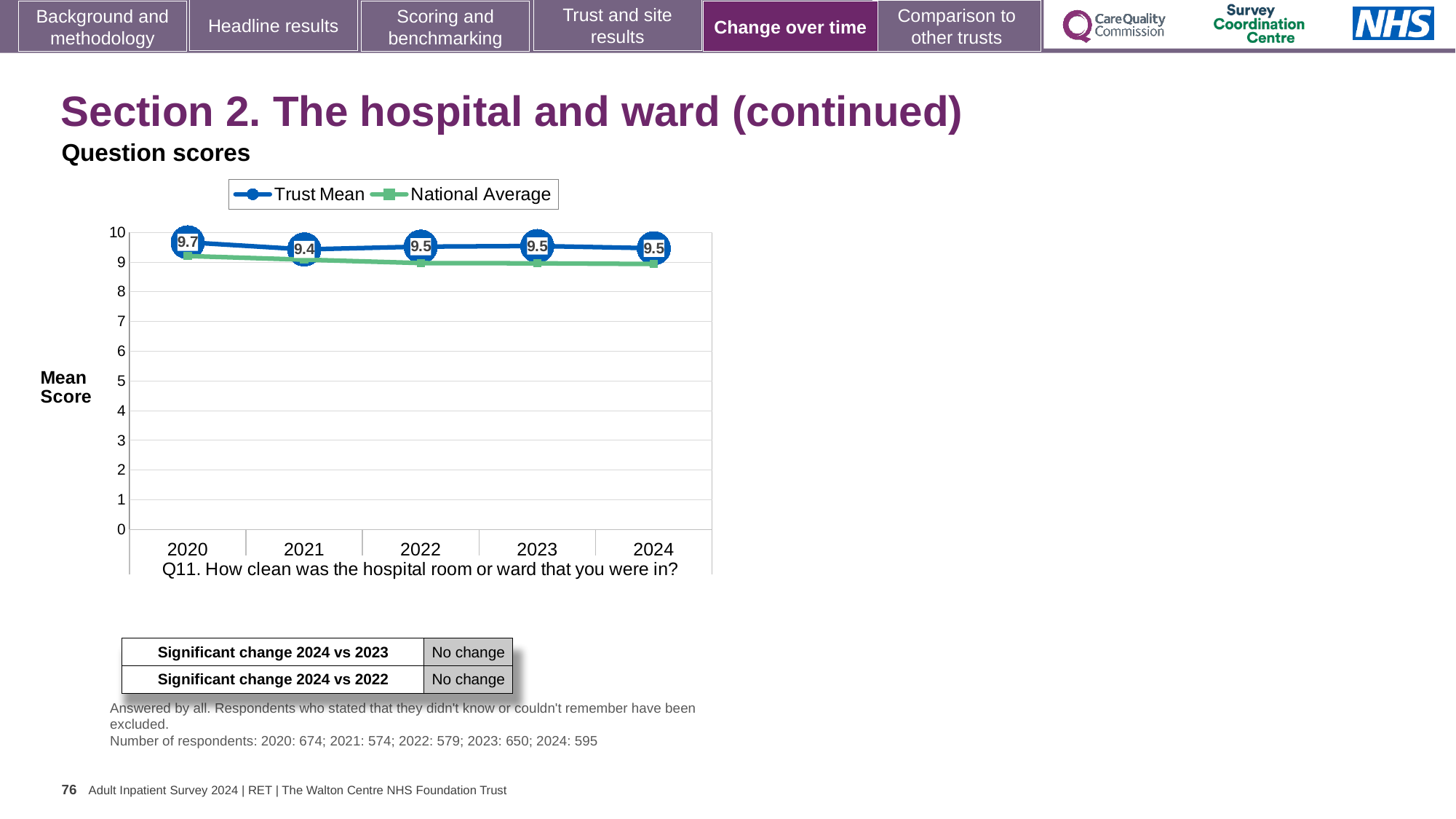
Is the National Average value for 2024 greater or less than 8? greater Which survey question does the chart show scores for? Q11. How clean was the hospital room or ward that you were in? What kind of chart is shown on the slide? Line chart What is the Trust Mean value for 2024? 9.5 How many series does the legend list? 2 What is the Trust Mean value for 2020? 9.7 In which year is the Trust Mean lowest? 2021 What is the difference between the Trust Mean in 2020 and in 2021? 0.3 In which year is the Trust Mean highest? 2020 In 2020, which series has the higher value, Trust Mean or National Average? Trust Mean What is the Trust Mean value for 2021? 9.4 How many years are shown on the x axis? 5